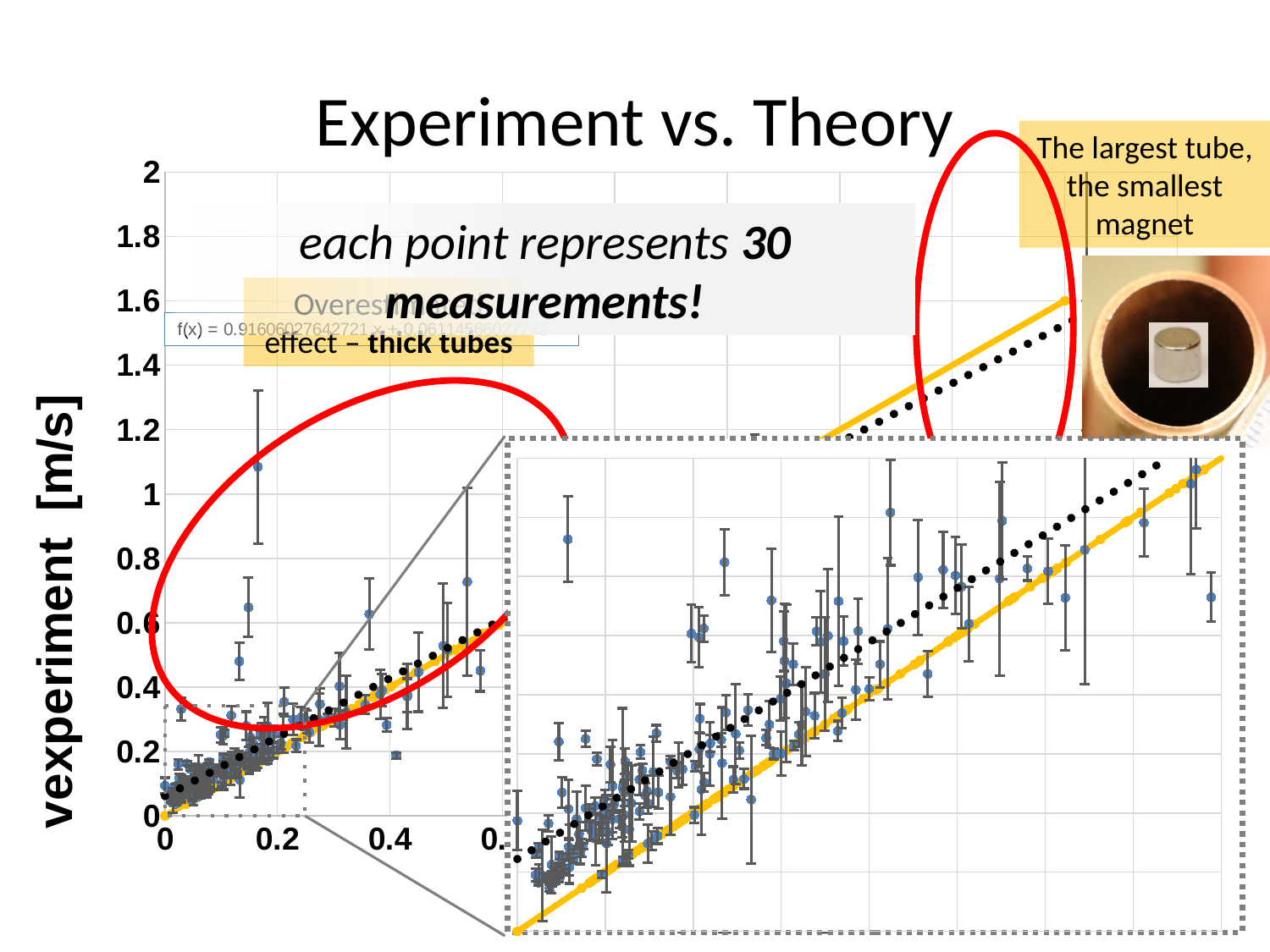
What kind of chart is shown on the slide? scatter chart What is the highest tick value shown on the vertical axis of the main chart? 2 Is the highest plotted point in the main chart (near x = 0.2) greater or less than 1 on the vertical axis? greater What is the title of the slide's chart? Experiment vs. Theory What is the label of the vertical axis of the main chart? vexperiment [m/s] What is the spacing between consecutive tick marks on the vertical axis of the main chart? 0.2 Is the plotted point near x = 0.4 with the tallest error bar greater or less than 0.8 on the vertical axis? less Do the plotted values in the main chart generally rise or fall as the x value increases? rise